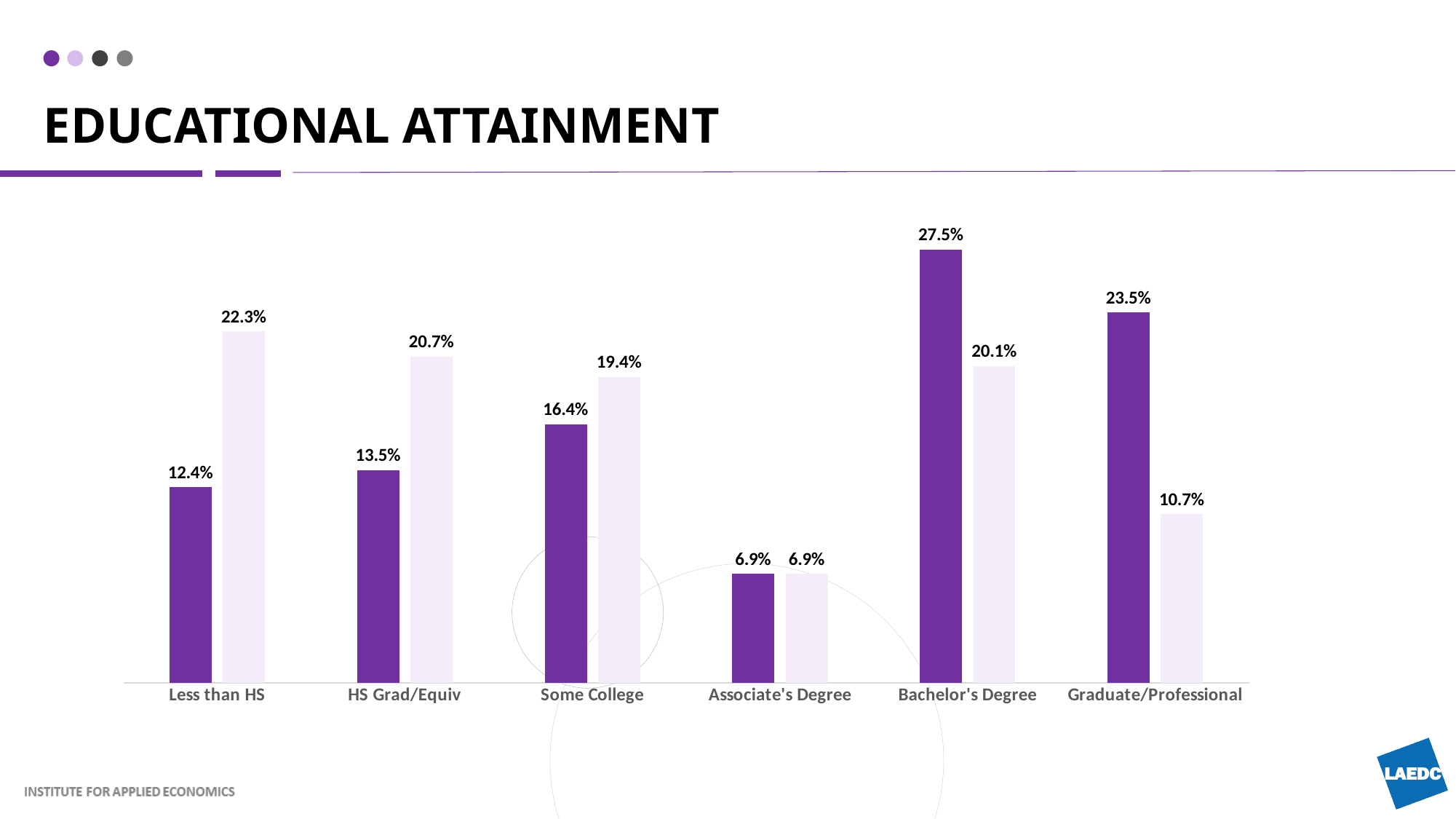
What is the value of the dark purple bar for Some College? 16.4% What is the value of the light purple bar for Graduate/Professional? 10.7% How many education categories are shown on the x axis? 6 What is the title of the slide containing the chart? EDUCATIONAL ATTAINMENT Which category has the highest dark purple bar? Bachelor's Degree For HS Grad/Equiv, which bar is larger, the dark purple or the light purple? light purple What is the difference between the light purple and dark purple bars for Less than HS? 9.9% What type of chart is shown on the slide? bar chart Which category has the lowest light purple bar? Associate's Degree What is the value of the light purple bar for Less than HS? 22.3% What is the value of the dark purple bar for Bachelor's Degree? 27.5% What is the difference between the dark purple and light purple bars for Graduate/Professional? 12.8%